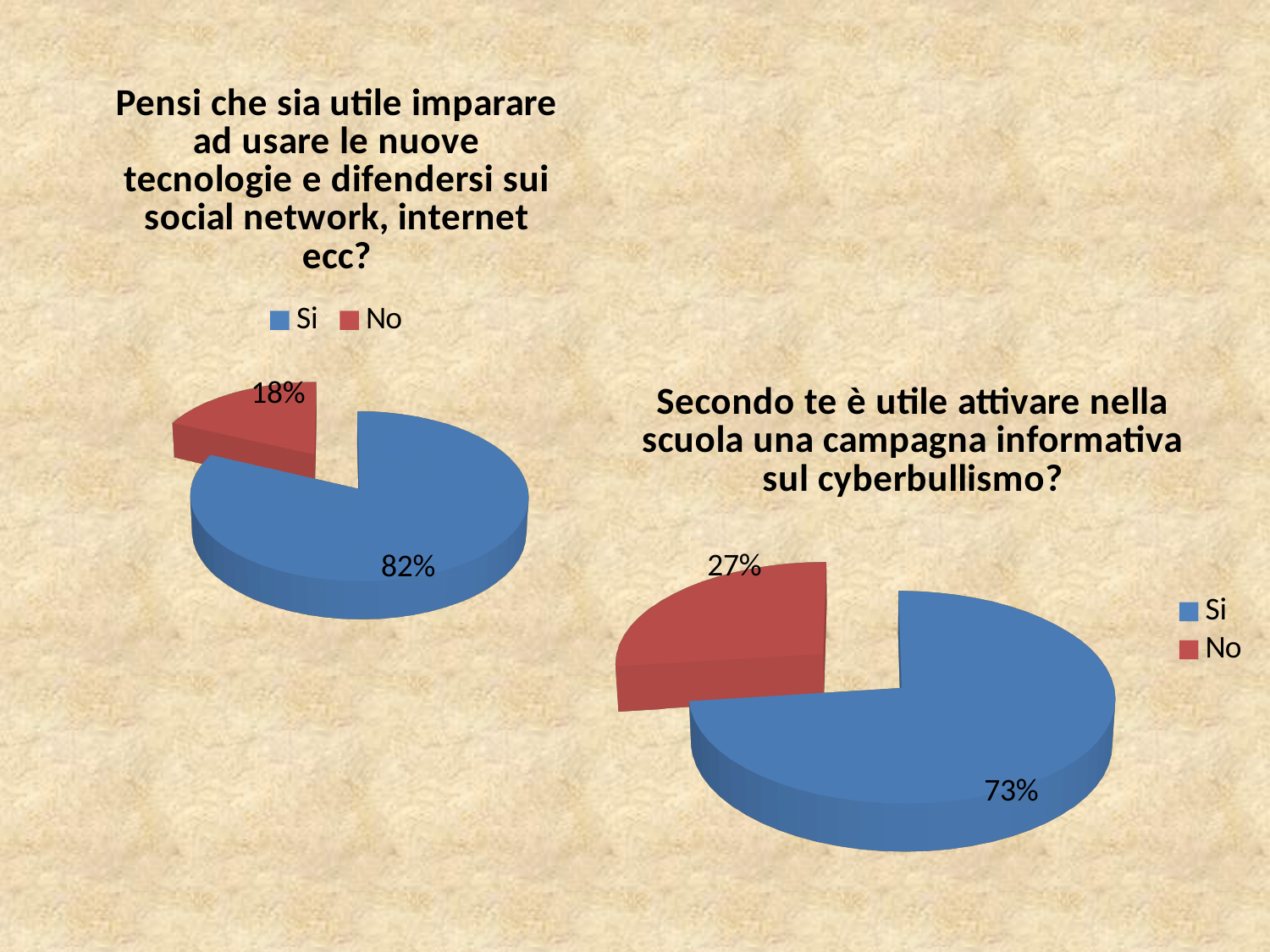
What type of chart is used on the left of the slide? Pie chart How many entries does the legend of the right chart list? 2 In the left chart ("Pensi che sia utile imparare ad usare le nuove tecnologie..."), what percentage answered Si? 82% In the left chart ("Pensi che sia utile imparare ad usare le nuove tecnologie..."), what percentage answered No? 18% In the left chart, which answer has the largest share? Si In the right chart ("Secondo te è utile attivare nella scuola una campagna informativa sul cyberbullismo?"), what percentage answered No? 27% In the right chart, what is the difference between the Si and No percentages? 46% In the right chart, what colour is the Si slice? Blue Which chart has the larger No share, the left chart or the right chart? The right chart In the right chart ("Secondo te è utile attivare nella scuola una campagna informativa sul cyberbullismo?"), what percentage answered Si? 73% In the right chart, which answer has the smallest share? No In the left chart, what is the difference between the Si and No percentages? 64%